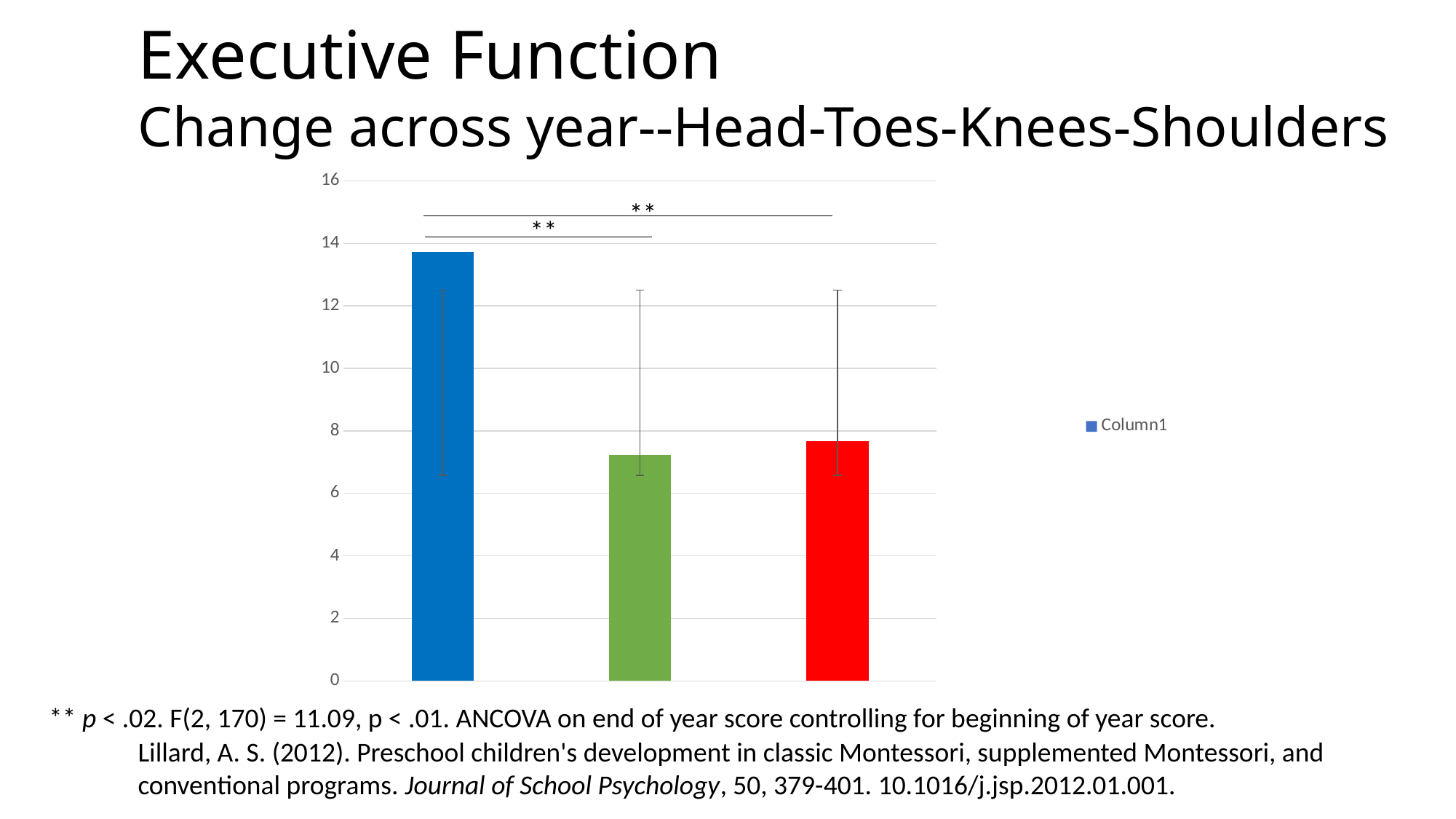
Which bar is the shortest in the chart: the blue, green, or red bar? green What is the legend entry shown next to the chart? Column1 What kind of chart is shown on the slide? bar chart Is the value of the blue bar greater or less than 12? greater How many series does the legend list? 1 Is the value of the blue bar greater or less than 14? less Which bar is the tallest in the chart: the blue, green, or red bar? blue What is the maximum value shown on the vertical axis of the chart? 16 Which is larger, the value of the blue bar or the value of the red bar? blue bar Is the value of the green bar greater or less than 8? less How many bars are plotted in the chart? 3